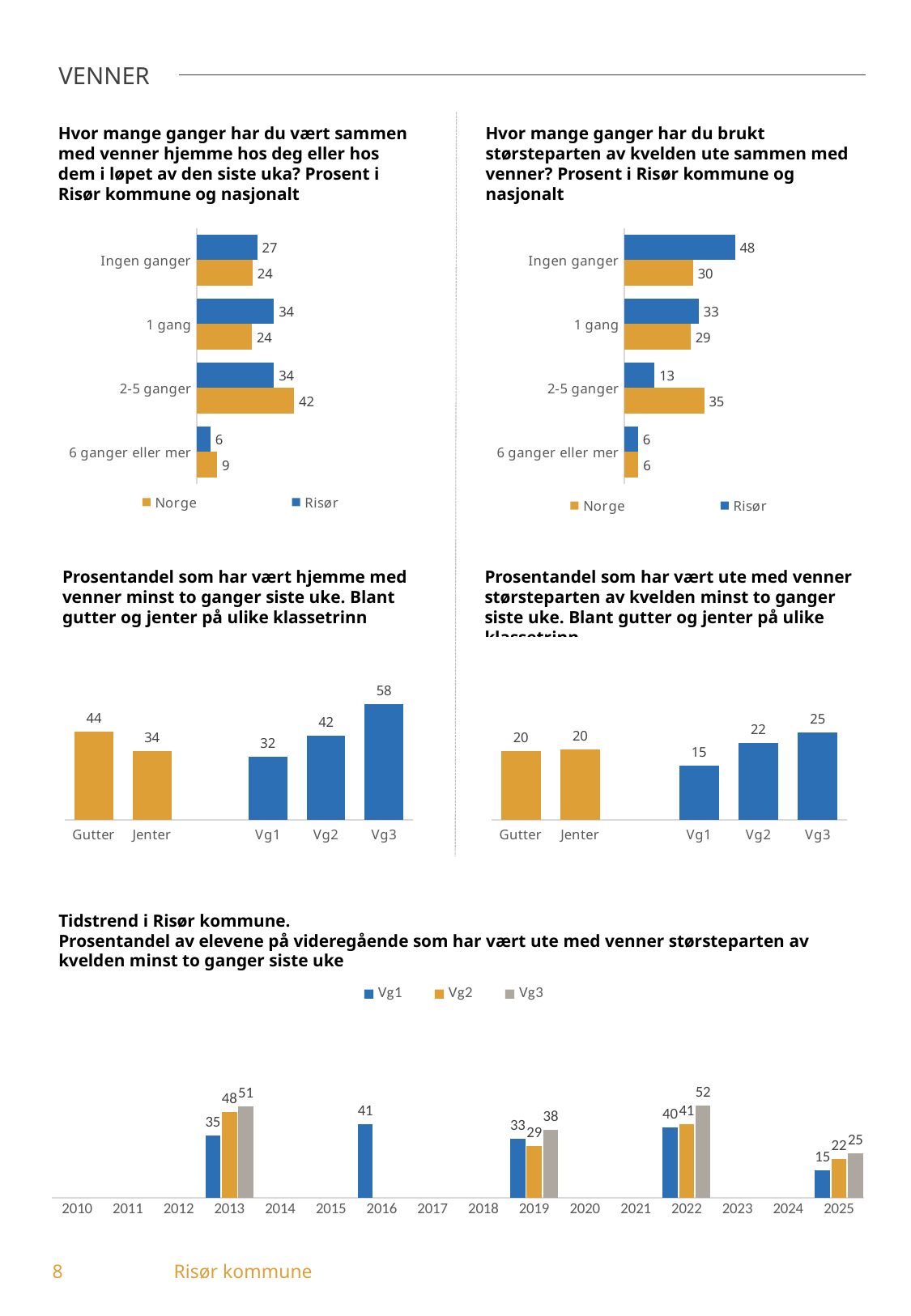
In the top-right chart (ute sammen med venner), how many series does the legend list? 2 In the top-left chart (venner hjemme), what is the difference between Norge and Risør for '2-5 ganger'? 8 In the top-left chart (venner hjemme), what is the value for Risør for '2-5 ganger'? 34 In the middle-right chart (ute med venner minst to ganger), how many categories are shown? 5 In the middle-left chart (hjemme med venner minst to ganger), what is the value for Gutter? 44 In the bottom chart (Tidstrend i Risør kommune), what is the value for Vg3 in 2022? 52 In the middle-right chart (ute med venner minst to ganger), which category has the lowest value? Vg1 In the top-right chart (ute sammen med venner), which is larger for '2-5 ganger', Norge or Risør? Norge What kind of chart is the bottom chart (Tidstrend i Risør kommune)? Bar chart In the bottom chart (Tidstrend i Risør kommune), what is the difference between Vg2 in 2022 and Vg2 in 2025? 19 In the top-right chart (ute sammen med venner), what is the value for Risør for 'Ingen ganger'? 48 In the middle-left chart (hjemme med venner minst to ganger), which category has the highest value? Vg3